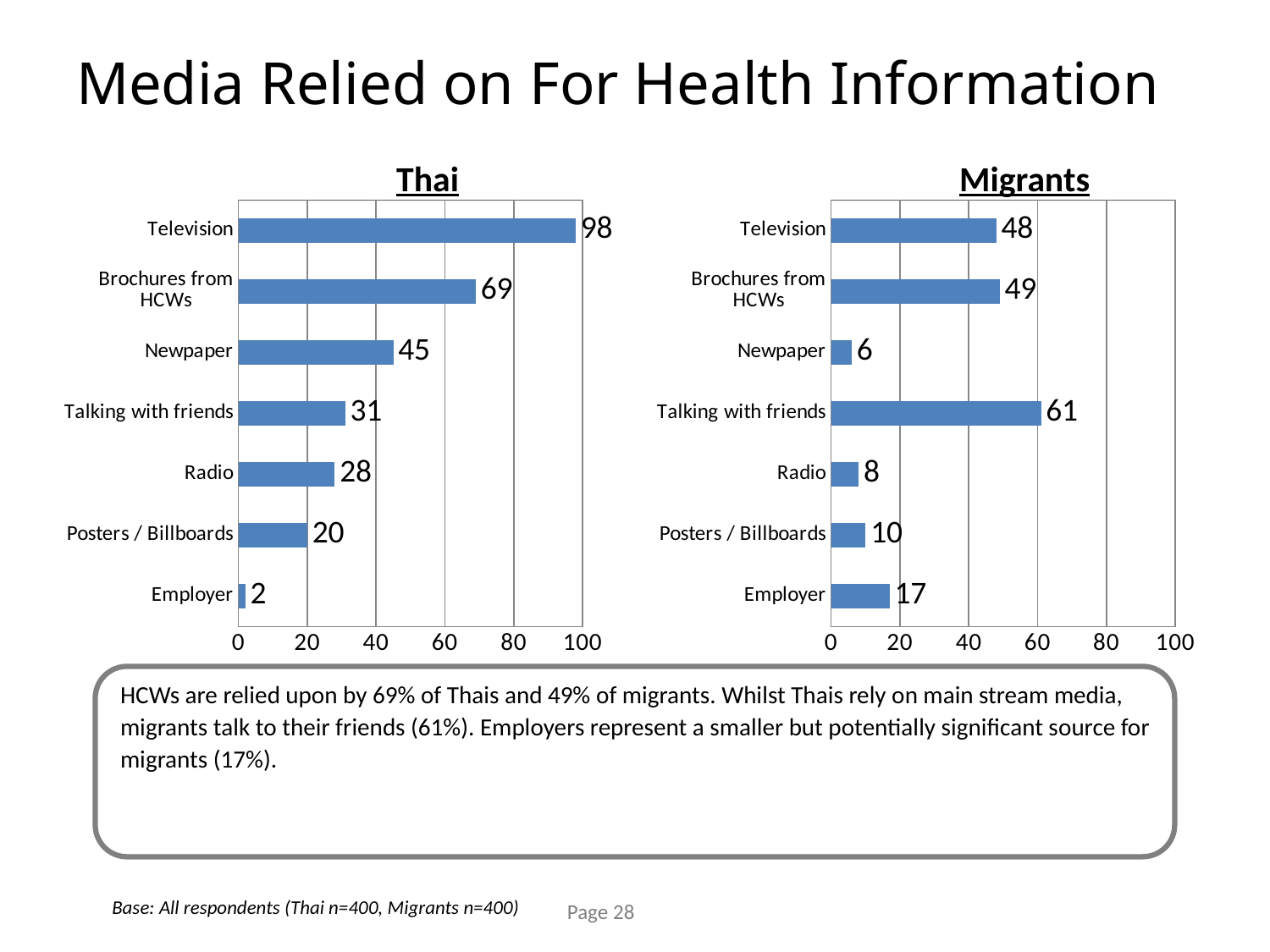
In the Thai chart, which is larger, the value for Radio or the value for Posters / Billboards? Radio In the Migrants chart, what is the value for Talking with friends? 61 How many categories are shown in the Migrants chart? 7 In the Migrants chart, which category has the highest value? Talking with friends In the Migrants chart, which category has the lowest value? Newpaper What is the title of the chart on the right side of the slide? Migrants In the Migrants chart, what is the difference between the values for Talking with friends and Television? 13 In the Thai chart, which category has the lowest value? Employer In the Thai chart, what is the value for Television? 98 In the Thai chart, what is the difference between the values for Television and Brochures from HCWs? 29 In the Migrants chart, what is the value for Employer? 17 What type of chart is the Thai chart? Bar chart